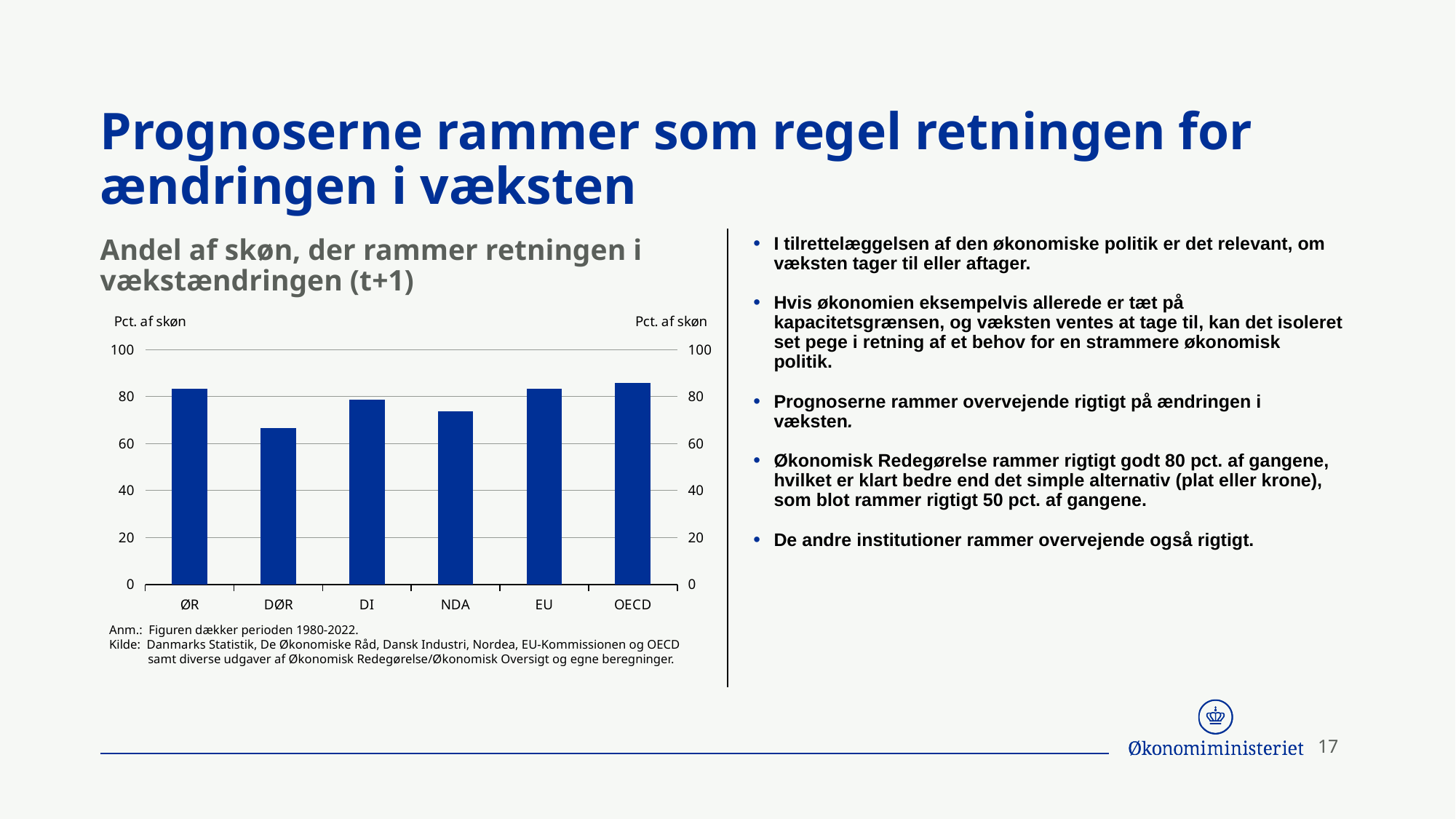
Is the value for OECD greater or less than 80? greater How many categories (institutions) are shown on the x axis of the chart? 6 Which category has the highest bar in the chart? OECD Which is larger, the value for ØR or the value for DØR? ØR Is the value for DØR greater or less than 80? less What kind of chart is shown on the slide? bar chart Is the value for NDA greater or less than 80? less Which is larger, the value for NDA or the value for OECD? OECD What is the title of the chart? Andel af skøn, der rammer retningen i vækstændringen (t+1) Which category has the lowest bar in the chart? DØR What unit label is shown on the chart's vertical axes? Pct. af skøn